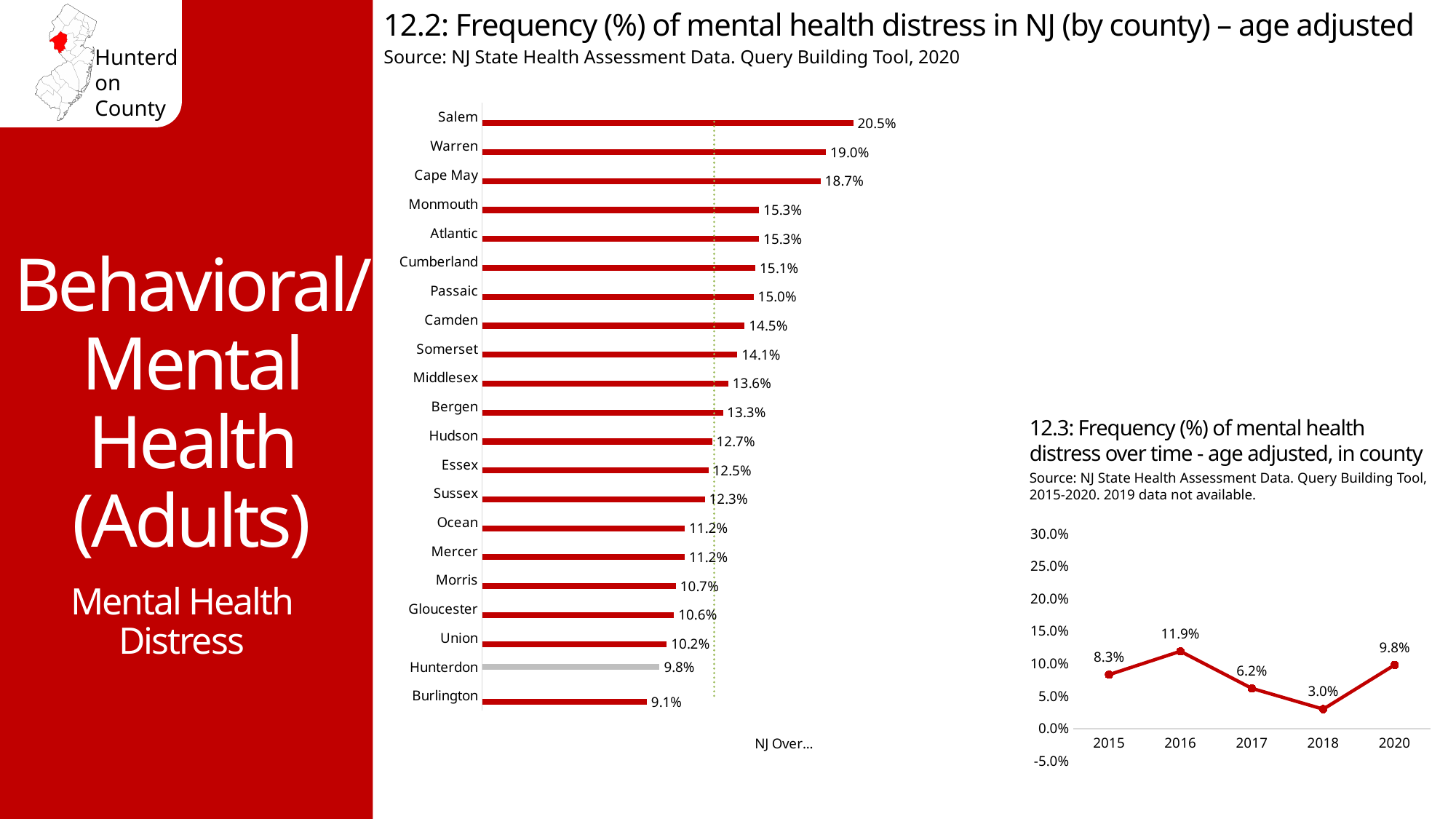
In chart 12.2 (Frequency of mental health distress in NJ by county), which is larger, the value for Warren or the value for Cape May? Warren In chart 12.3 (Frequency of mental health distress over time in county), what is the difference between the values for 2016 and 2017? 5.7% In chart 12.3 (Frequency of mental health distress over time in county), how many years are plotted? 5 In chart 12.2 (Frequency of mental health distress in NJ by county), which county has the lowest value? Burlington In chart 12.2 (Frequency of mental health distress in NJ by county), what is the value for Hunterdon? 9.8% In chart 12.2 (Frequency of mental health distress in NJ by county), what is the difference between the values for Salem and Burlington? 11.4% In chart 12.3 (Frequency of mental health distress over time in county), which year has the highest value? 2016 In chart 12.2 (Frequency of mental health distress in NJ by county), how many counties are shown? 21 In chart 12.2 (Frequency of mental health distress in NJ by county), what is the value for Middlesex? 13.6% What kind of chart is chart 12.2 (Frequency of mental health distress in NJ by county)? Bar chart In chart 12.2 (Frequency of mental health distress in NJ by county), which county has the highest value? Salem In chart 12.3 (Frequency of mental health distress over time in county), what is the value for 2018? 3.0%